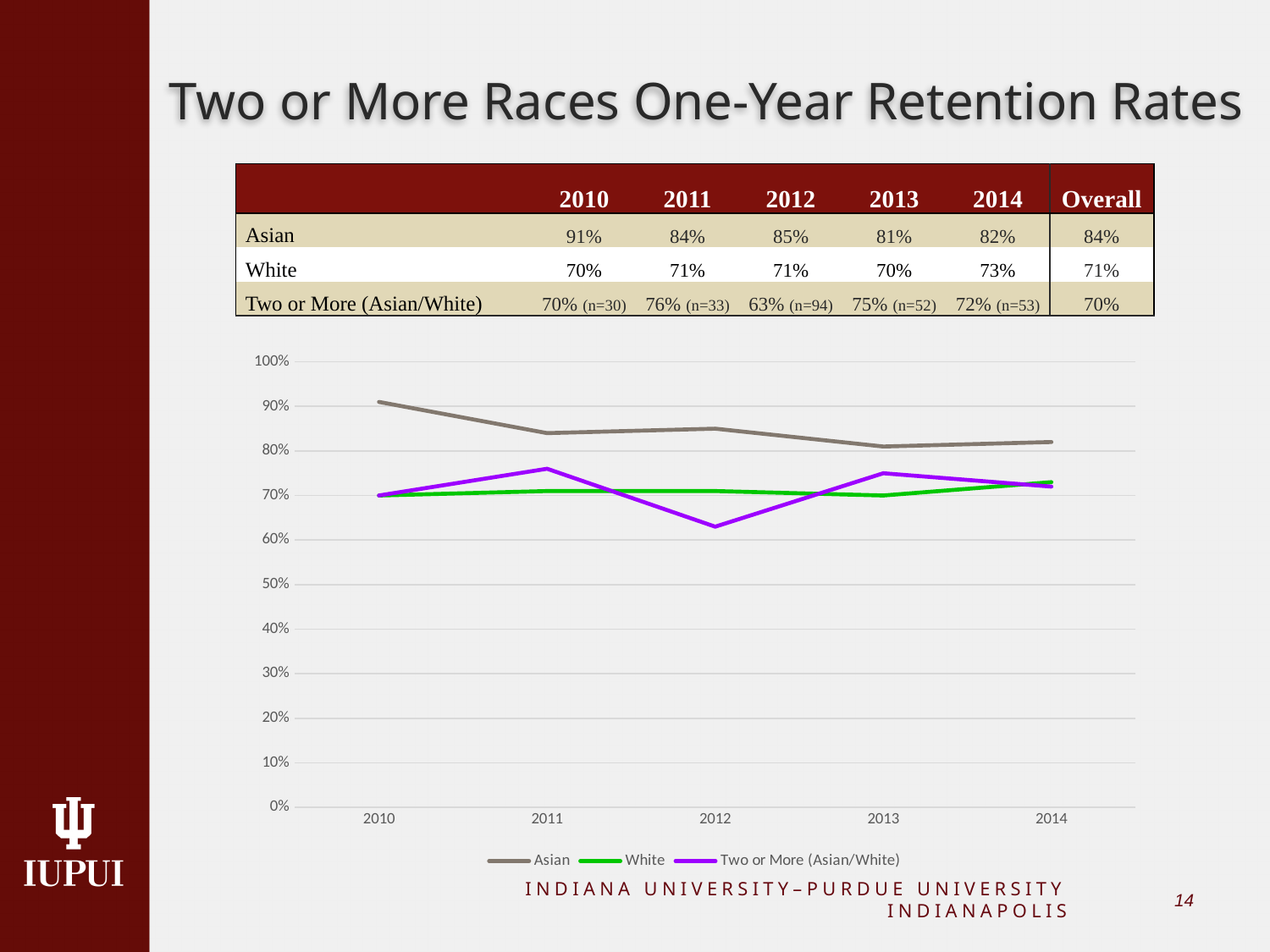
How many series does the chart legend list? 3 In which year was the Asian retention rate lowest? 2013 How many years are plotted along the x axis of the chart? 5 Which series is drawn in purple on the chart? Two or More (Asian/White) What kind of chart is shown on the slide? line chart In which year was the Two or More (Asian/White) retention rate highest? 2011 Is the Asian retention rate in 2010 greater or less than 90%? greater What is the difference between the Asian and White retention rates in 2010? 21 percentage points What was the one-year retention rate for Two or More (Asian/White) students in 2012? 63% Which series had the higher retention rate in 2013, White or Two or More (Asian/White)? Two or More (Asian/White) What was the one-year retention rate for Asian students in 2010? 91% What was the one-year retention rate for White students in 2014? 73%